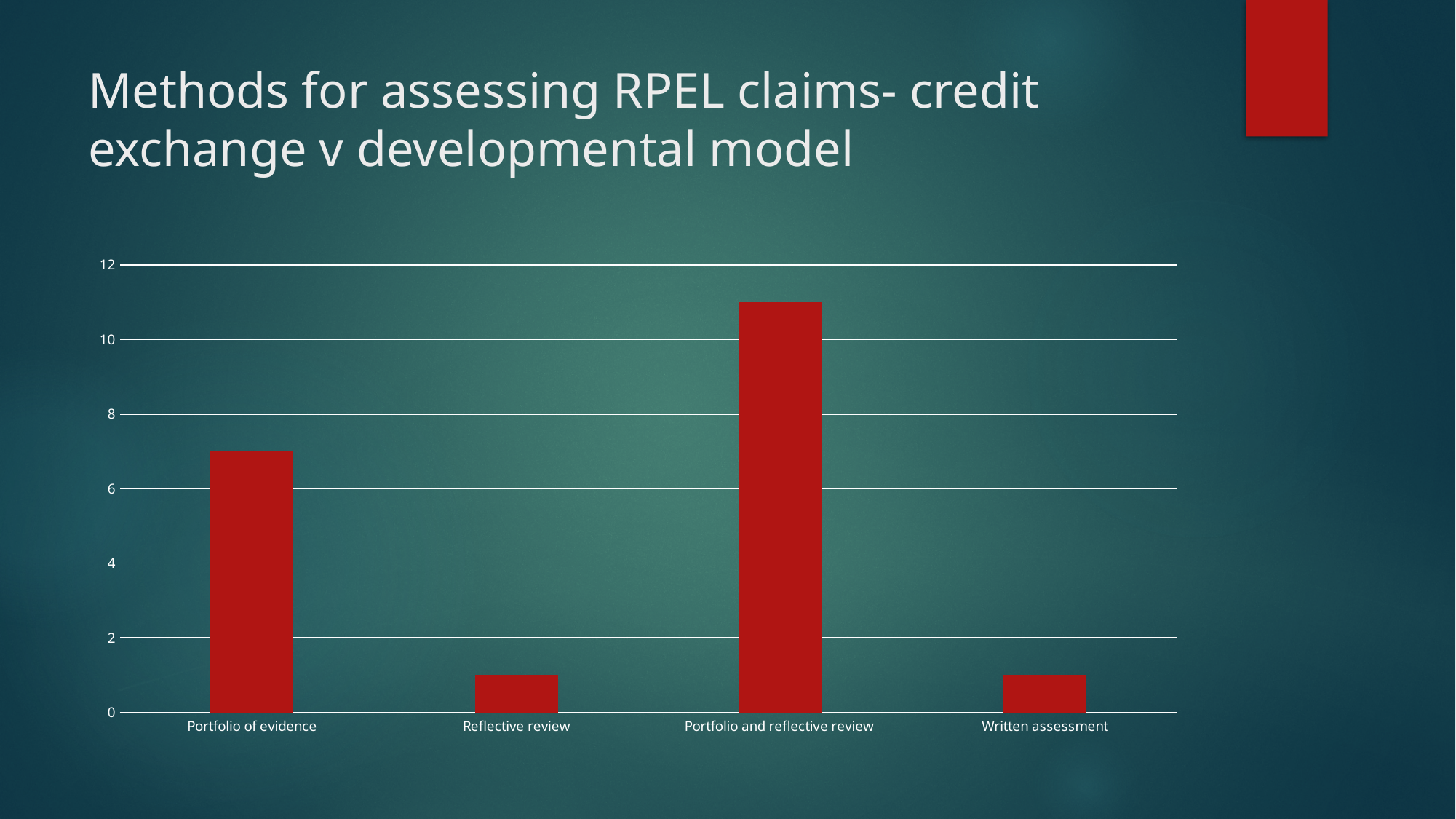
Is the value for Written assessment greater or less than 2? less What kind of chart is shown on the slide? bar chart Is the value for Portfolio of evidence greater or less than 6? greater What is the title of the slide containing the chart? Methods for assessing RPEL claims- credit exchange v developmental model How many categories are shown on the x axis of the chart? 4 Is the value for Portfolio of evidence greater or less than 8? less Which is larger, the value for Reflective review or the value for Portfolio and reflective review? Portfolio and reflective review What colour are the bars in the chart? red Which is larger, the value for Portfolio of evidence or the value for Written assessment? Portfolio of evidence Which category has the highest bar in the chart? Portfolio and reflective review